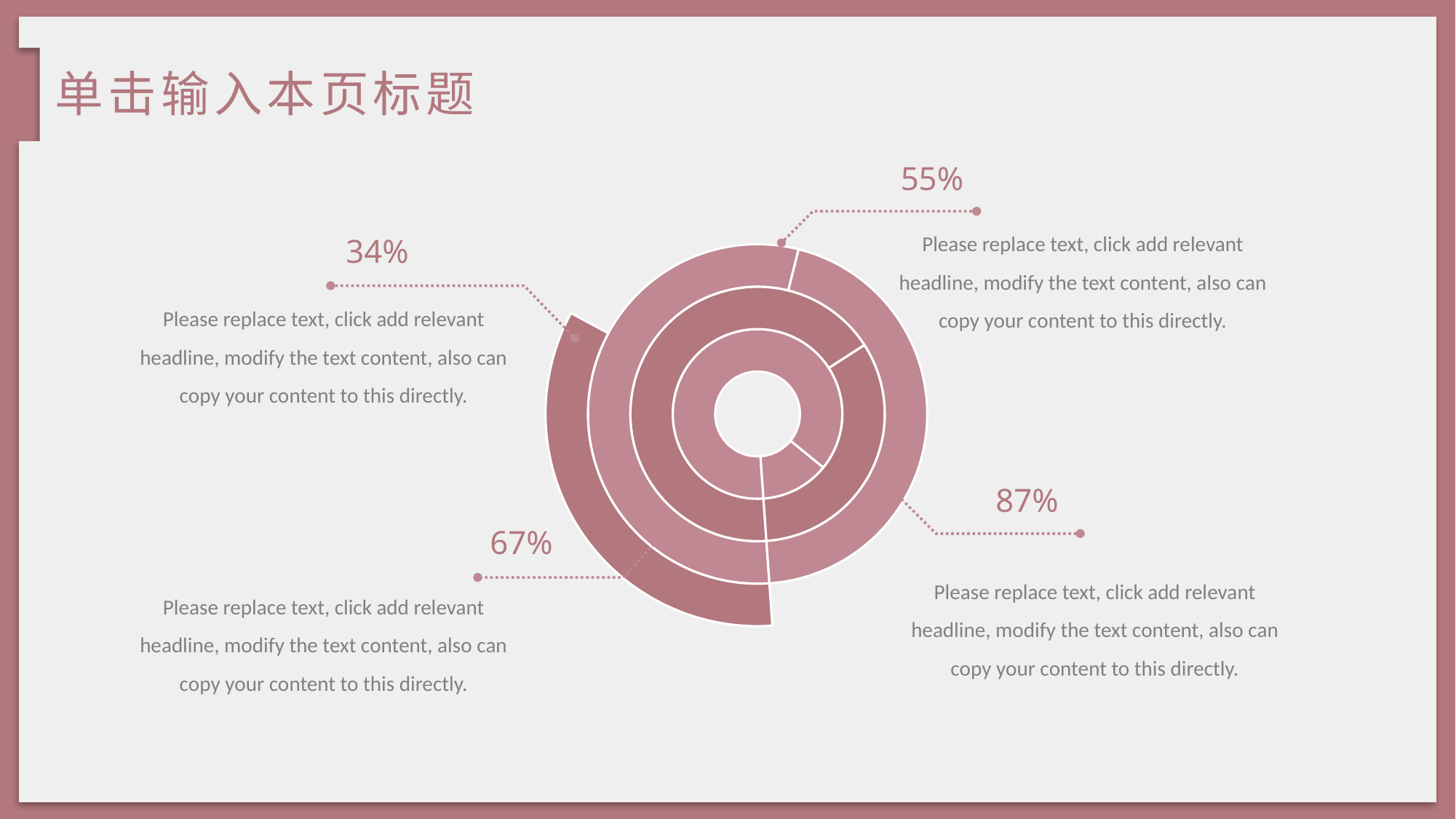
What is the lowest percentage labelled on the chart? 34% How many percentage values are labelled around the chart? 4 What is the highest percentage labelled on the chart? 87% What kind of chart is shown on the slide? doughnut chart What percentage is shown in the callout at the top left of the chart? 34% What percentage is shown in the callout at the bottom right of the chart? 87% What percentage is shown in the callout at the top right of the chart? 55% What percentage is shown in the callout at the bottom left of the chart? 67% Which is larger, the percentage in the top-right callout or the percentage in the bottom-left callout? bottom-left (67%) How many concentric rings does the chart have? 4 What is the difference between the highest and lowest percentages labelled on the chart? 53 percentage points What is the difference between the bottom-right value and the top-right value? 32 percentage points